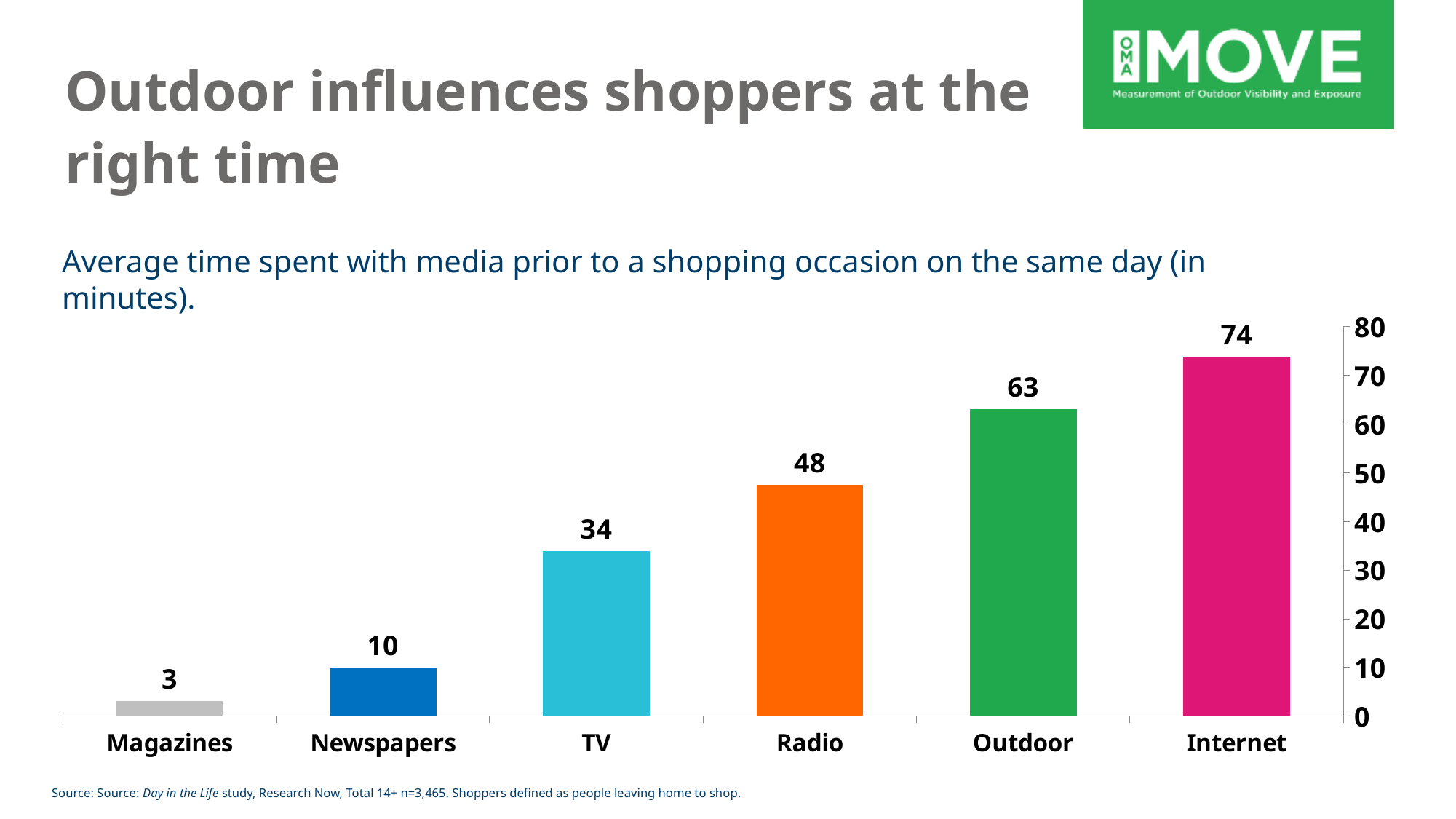
Which is larger, the value for Radio or the value for TV? Radio Which media category has the lowest value? Magazines What is the difference between the values for Internet and Outdoor? 11 What is the value shown for Magazines? 3 Which media category has the highest value? Internet Is the value for Outdoor greater or less than 60? greater What is the value shown for TV? 34 Do the values rise or fall moving from left to right along the x axis? rise What is the average time spent with Outdoor media prior to a shopping occasion? 63 What is the difference between the values for Radio and Newspapers? 38 What kind of chart is shown on the slide? bar chart How many media categories are shown on the chart? 6